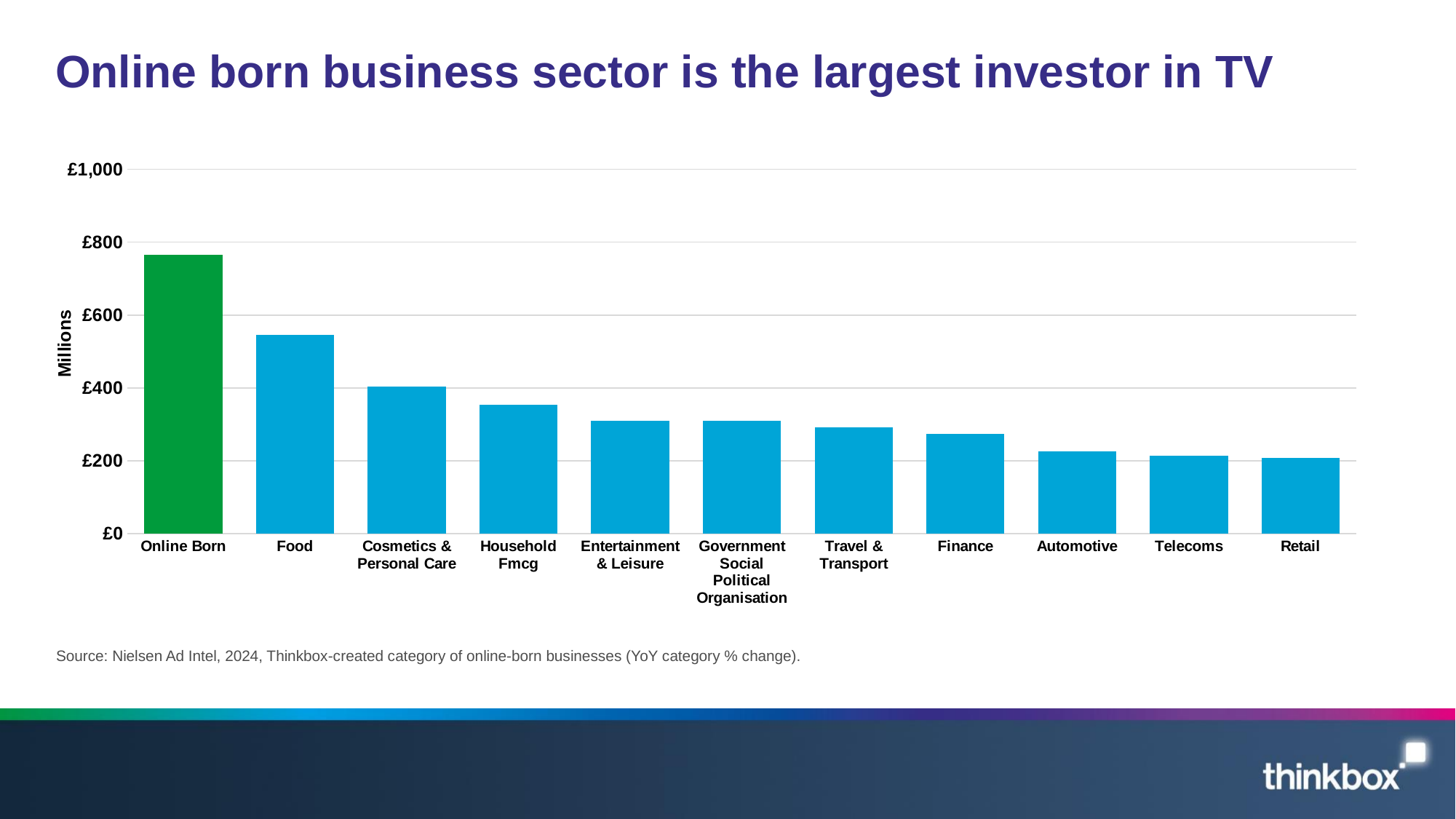
What colour is the Online Born bar? green Is the value for Food greater or less than £600? less Which sector has the highest TV investment in the chart? Online Born Is the value for Household Fmcg greater or less than £400? less Is the value for Finance greater or less than £400? less Which is larger, the value for Online Born or the value for Food? Online Born Which is larger, the value for Food or the value for Cosmetics & Personal Care? Food What kind of chart is shown on the slide? bar chart How many sectors are shown on the x axis of the chart? 11 Do the bar values rise or fall moving from left to right along the x axis? fall